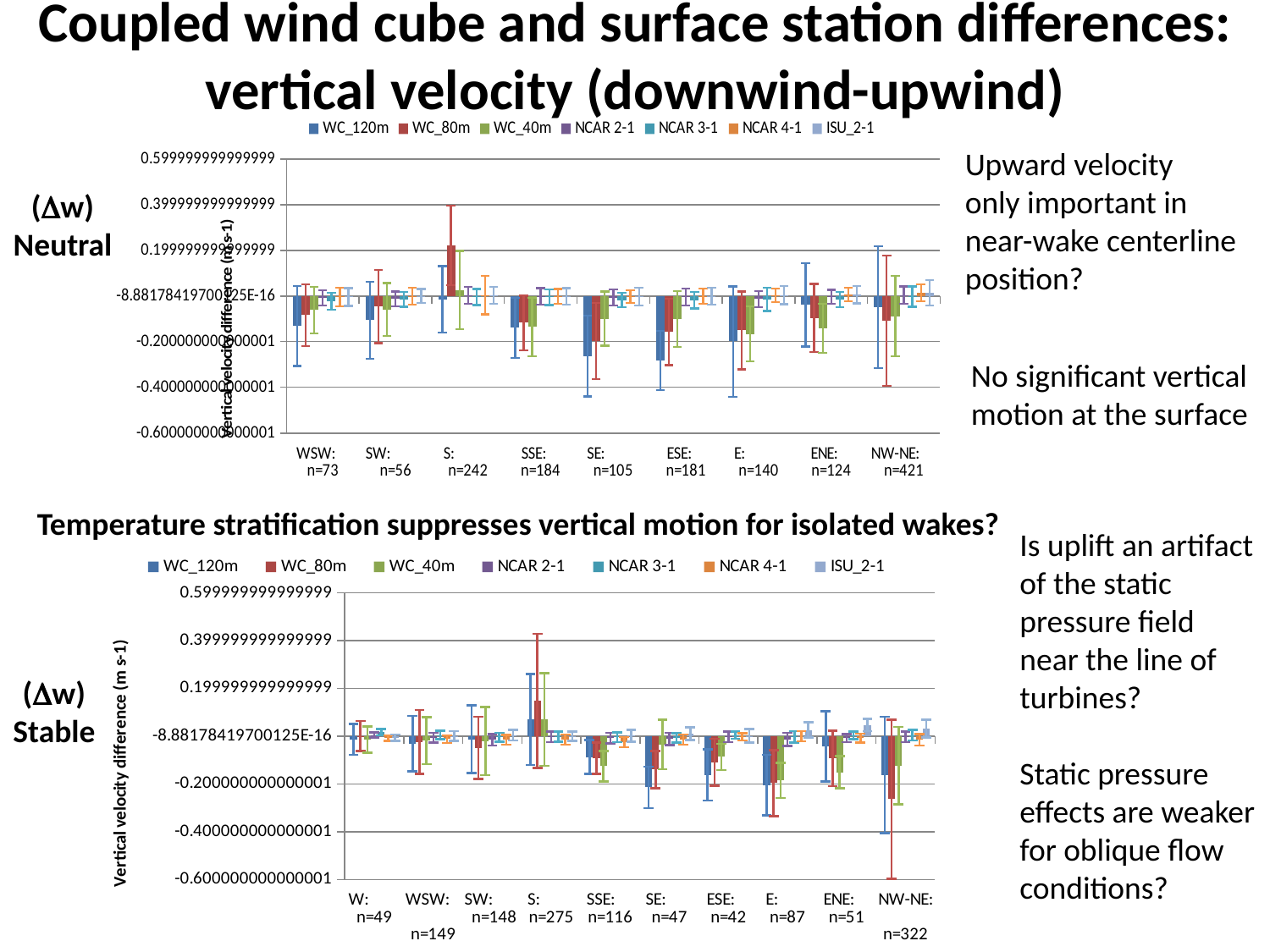
What is the first series listed in the legend of the bottom (Stable) chart? WC_120m How many series does the legend of the bottom (Stable) chart list? 7 How many wind-direction categories are shown on the x axis of the bottom (Stable) chart? 10 How many wind-direction categories are shown on the x axis of the top (Neutral) chart? 9 In the top (Neutral) chart, which is larger: the WC_80m value for S: n=242 or the WC_80m value for WSW: n=73? S: n=242 In the top (Neutral) chart, is the WC_80m value for S: n=242 greater or less than 0? greater In the bottom (Stable) chart, is the WC_120m value for SE: n=47 greater or less than 0? less How many series does the legend of the top (Neutral) chart list? 7 What type of chart is the bottom (Stable) chart on the slide? bar chart What type of chart is the top (Neutral) chart on the slide? bar chart In the top (Neutral) chart, which category has the tallest positive WC_80m bar? S: n=242 In the bottom (Stable) chart, which category has the tallest positive WC_80m bar? S: n=275